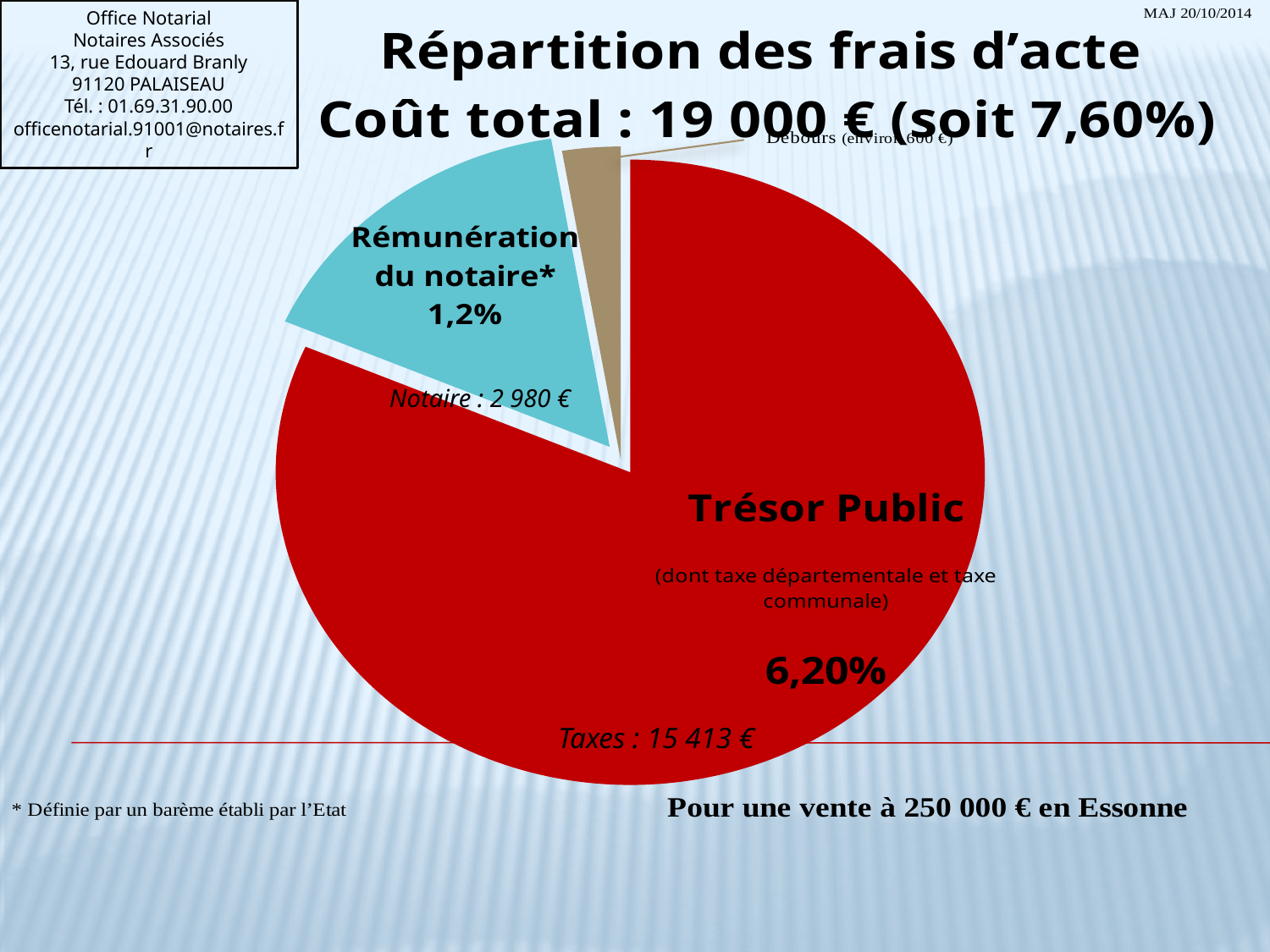
What total cost is stated in the chart title? 19 000 € What is the difference in euros between Taxes (15 413 €) and Notaire (2 980 €)? 12 433 € What percentage is shown for the Trésor Public slice? 6,20% Which is larger, the Trésor Public slice or the Rémunération du notaire slice? Trésor Public What colour is the Trésor Public slice of the pie chart? red How many slices does the pie chart have? 3 What kind of chart is shown on the slide? pie chart What percentage is shown for the Rémunération du notaire slice? 1,2% Which slice of the pie chart is the smallest? Débours Which slice of the pie chart is the largest? Trésor Public What amount in euros is shown for Notaire (Rémunération du notaire) on the pie chart? 2 980 € What amount in euros is shown for Taxes (Trésor Public) on the pie chart? 15 413 €